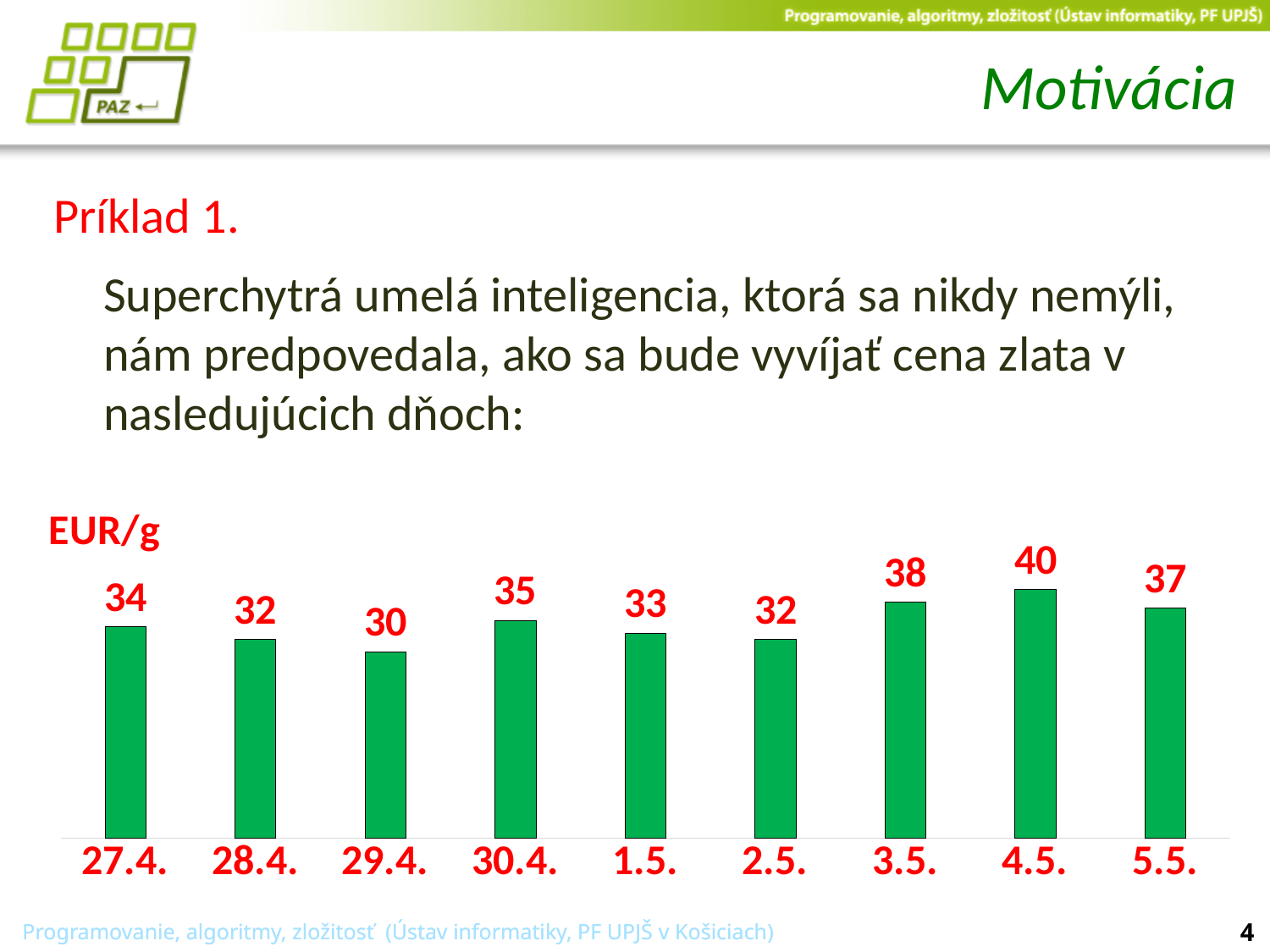
What kind of chart is shown on the slide? bar chart Which date has the lowest value? 29.4. What is the difference between the values for 4.5. and 29.4.? 10 What is the difference between the values for 30.4. and 1.5.? 2 What is the value for 29.4.? 30 What is the value for 3.5.? 38 What unit is shown above the chart? EUR/g Which date has the highest value? 4.5. Do the values rise or fall from 1.5. to 4.5.? They fall from 1.5. to 2.5., then rise to 4.5. How many dates are shown on the x axis? 9 Which is larger, the value for 28.4. or the value for 5.5.? 5.5. What is the value for 27.4.? 34